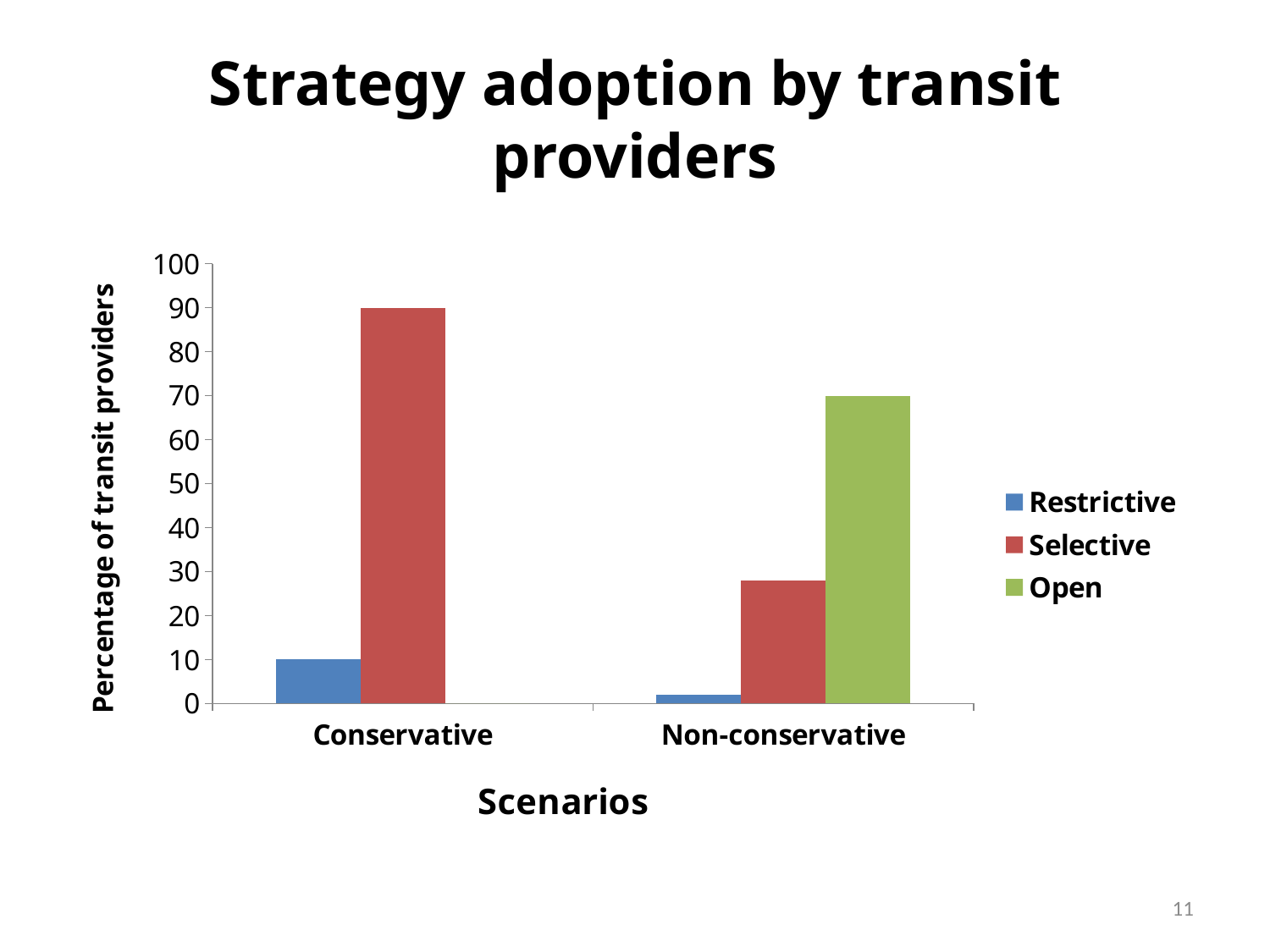
Which is larger: Selective in the Conservative scenario or Open in the Non-conservative scenario? Selective in the Conservative scenario Which strategy has the highest value in the Conservative scenario? Selective What is the value for Open in the Non-conservative scenario? 70 How many scenario categories are shown on the x axis? 2 Is the value for Restrictive in the Non-conservative scenario greater or less than 10? less What kind of chart is shown on the slide? bar chart Is the value for Selective in the Non-conservative scenario greater or less than 30? less What is the value for Restrictive in the Conservative scenario? 10 What is the difference between the Selective and Restrictive values in the Conservative scenario? 80 How many series does the legend list? 3 Which strategy has the highest value in the Non-conservative scenario? Open What is the value for Selective in the Conservative scenario? 90